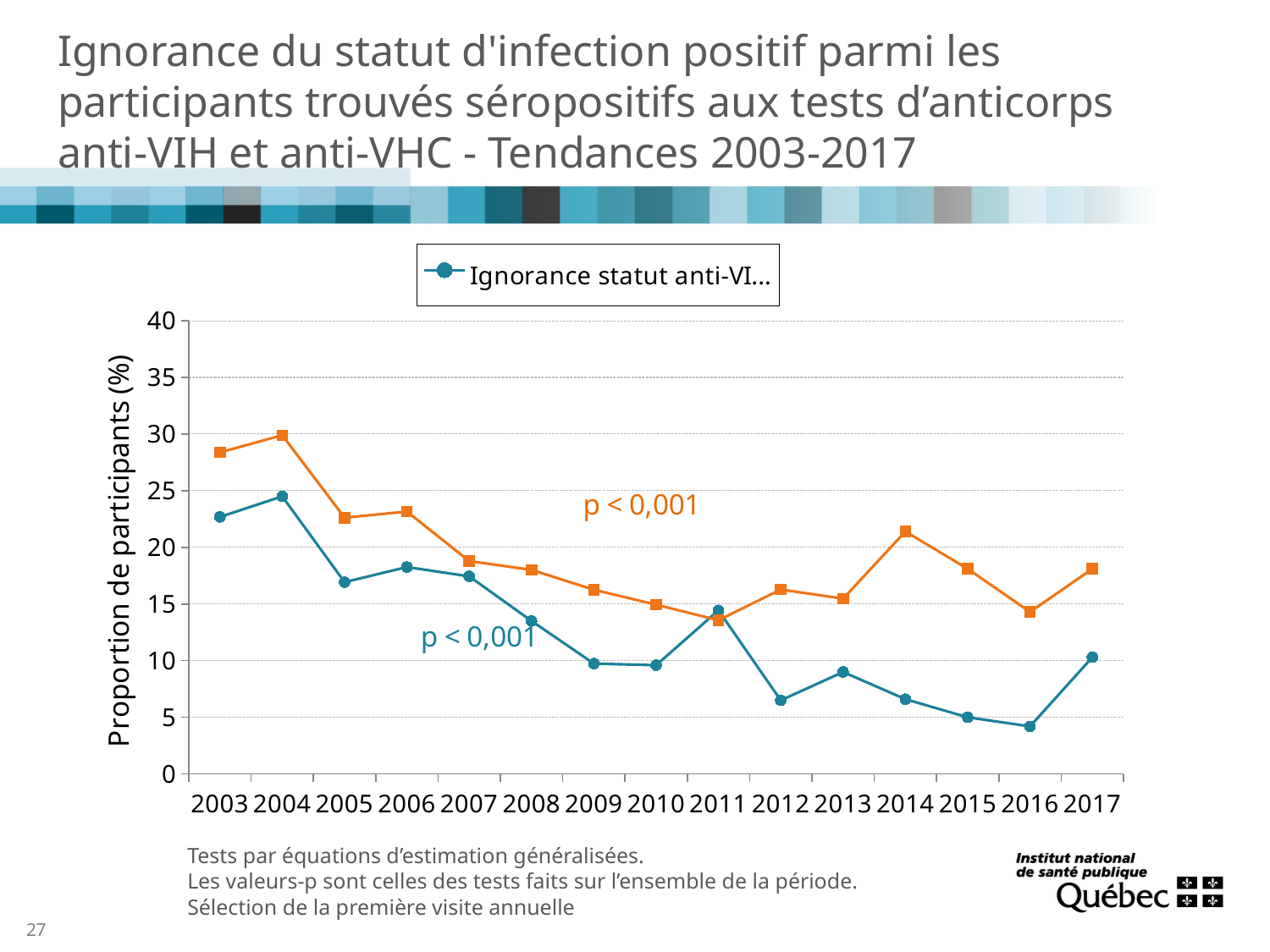
What p-value annotation is printed next to each line on the chart? p < 0,001 In 2014, which line has the higher value, the orange line (square markers) or the blue line (circle markers)? the orange line What kind of chart is shown on the slide? line chart In which year does the blue line (circle markers) reach its lowest value? 2016 In which year does the orange line (square markers) reach its highest value? 2004 In which year does the blue line (circle markers) reach its highest value? 2004 Is the value of the blue line (circle markers) in 2003 greater or less than 20? greater What is the label of the y axis? Proportion de participants (%) How many years are shown along the x axis of the chart? 15 How many lines are plotted on the chart? 2 Is the value of the blue line (circle markers) in 2016 greater or less than 5? less Is the value of the orange line (square markers) in 2003 greater or less than 25? greater